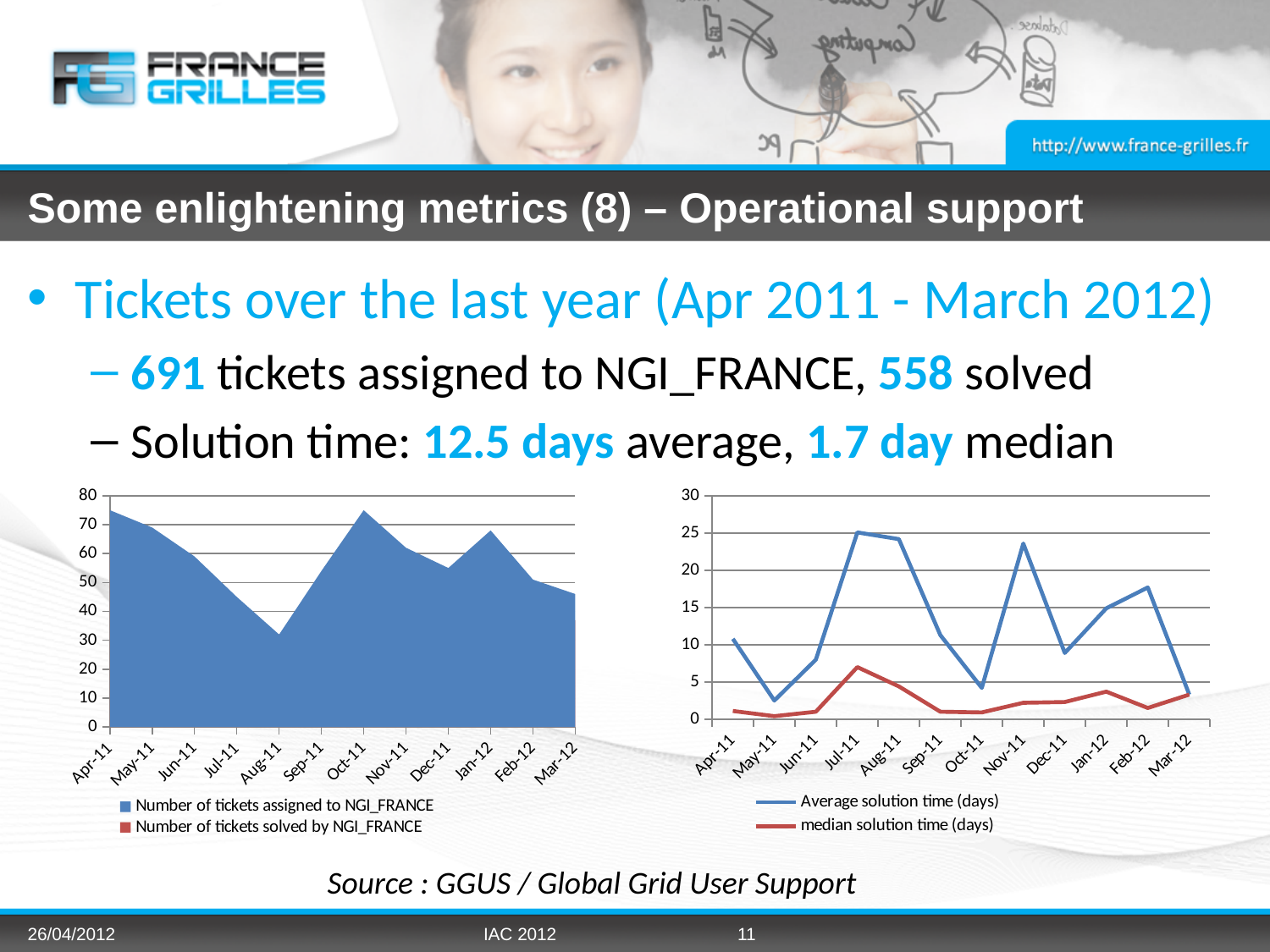
In the left chart, which month has the lowest number of tickets assigned to NGI_FRANCE? Aug-11 What kind of chart is the right chart showing solution time? Line chart How many months are plotted along the x axis of the left chart? 12 In the right chart, is the average solution time in Oct-11 greater or less than 5 days? less In the right chart, which series is drawn in red? median solution time (days) What kind of chart is the left chart showing the number of tickets? Area chart In the right chart, is the average solution time in Jul-11 greater or less than 20 days? greater How many series does the legend of the right chart list? 2 In the left chart, which month has more tickets assigned to NGI_FRANCE, Apr-11 or Aug-11? Apr-11 In the left chart, is the number of tickets assigned to NGI_FRANCE in Aug-11 greater or less than 40? less In the right chart, which month has the highest median solution time? Jul-11